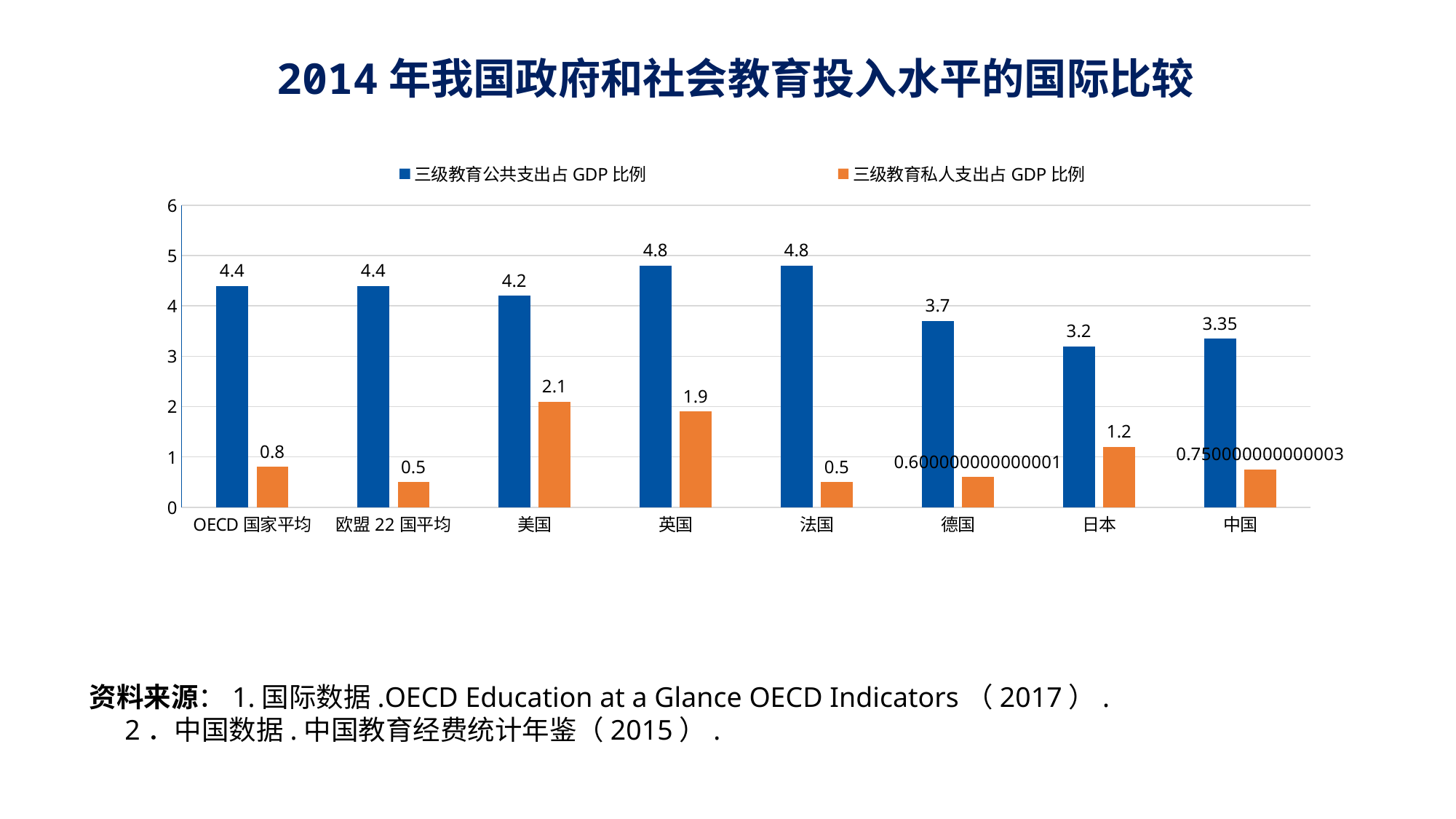
What is the title of the chart? 2014 年我国政府和社会教育投入水平的国际比较 How many series does the legend list? 2 Is the value of 三级教育公共支出占 GDP 比例 for 法国 greater or less than 4? greater What is the value of 三级教育私人支出占 GDP 比例 for 日本? 1.2 What is the value of 三级教育公共支出占 GDP 比例 for 中国? 3.35 What is the value of 三级教育公共支出占 GDP 比例 for 德国? 3.7 Which category has the highest value for 三级教育私人支出占 GDP 比例? 美国 What type of chart is shown on the slide? bar chart How many categories are shown on the x axis? 8 Which is larger: 三级教育公共支出占 GDP 比例 for 英国 or for 日本? 英国 What is the difference between 三级教育公共支出占 GDP 比例 and 三级教育私人支出占 GDP 比例 for 美国? 2.1 What is the value of 三级教育私人支出占 GDP 比例 for 美国? 2.1